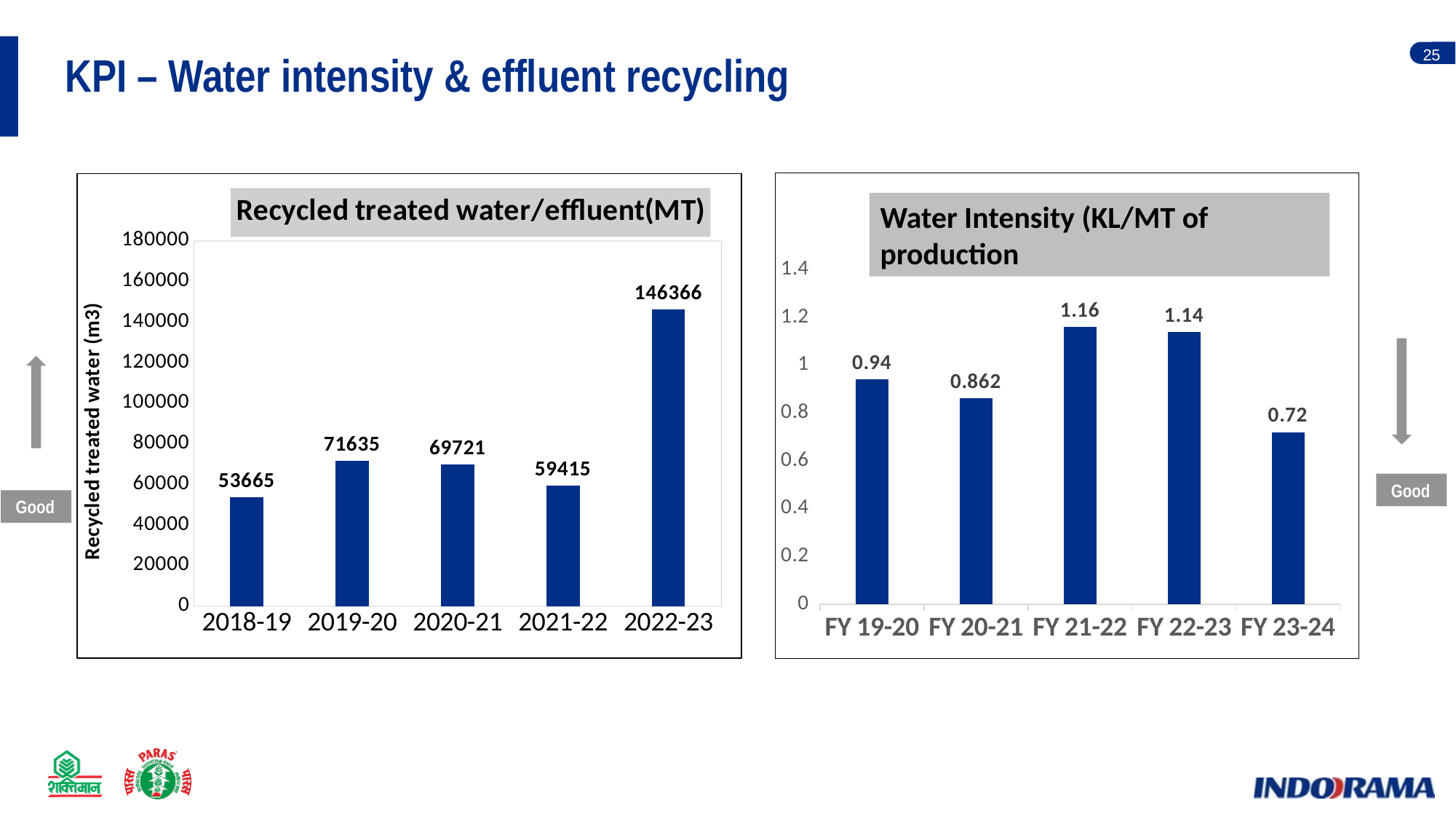
In the 'Recycled treated water/effluent(MT)' chart, which year has the lowest value? 2018-19 In the 'Recycled treated water/effluent(MT)' chart, what is the difference between the 2019-20 and 2018-19 values? 17970 In the 'Water Intensity (KL/MT of production' chart, what is the value for FY 20-21? 0.862 In the 'Water Intensity (KL/MT of production' chart, which fiscal year has the lowest value? FY 23-24 In the 'Recycled treated water/effluent(MT)' chart, what is the value for 2022-23? 146366 What type of chart is the 'Water Intensity (KL/MT of production' chart? Bar chart In the 'Water Intensity (KL/MT of production' chart, which is larger, the value for FY 19-20 or FY 20-21? FY 19-20 In the 'Recycled treated water/effluent(MT)' chart, what is the y-axis label? Recycled treated water (m3) In the 'Water Intensity (KL/MT of production' chart, which fiscal year has the highest value? FY 21-22 In the 'Recycled treated water/effluent(MT)' chart, is the value for 2021-22 greater or less than 60000? less In the 'Water Intensity (KL/MT of production' chart, what is the difference between the FY 21-22 and FY 23-24 values? 0.44 In the 'Recycled treated water/effluent(MT)' chart, how many years are shown on the x axis? 5